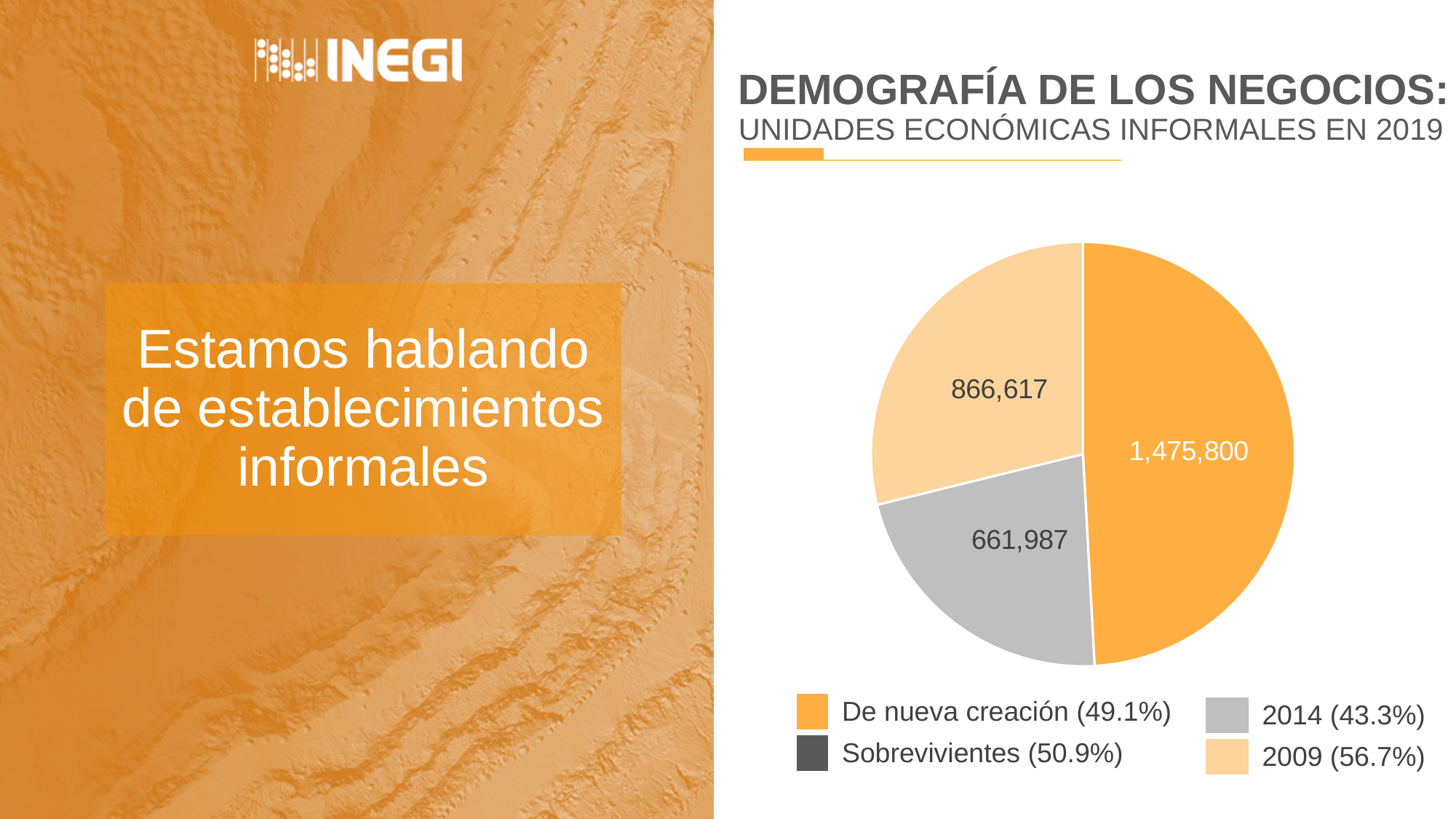
What is the difference between the 2009 slice and the 2014 slice? 204,630 What value is shown for the 2009 slice of the pie chart? 866,617 Which is larger, the 2009 slice or the 2014 slice? 2009 Which slice of the pie chart has the largest value? De nueva creación Which slice of the pie chart has the smallest value? 2014 What value is shown for the 2014 slice of the pie chart? 661,987 How many slices does the pie chart have? 3 What value is shown for the 'De nueva creación' slice of the pie chart? 1,475,800 What percentage is shown in the legend next to 'Sobrevivientes'? 50.9% What share of the pie does 'De nueva creación' represent, according to the legend? 49.1% What is the difference between the 'De nueva creación' slice and the 2009 slice? 609,183 What type of chart is shown on the slide? Pie chart